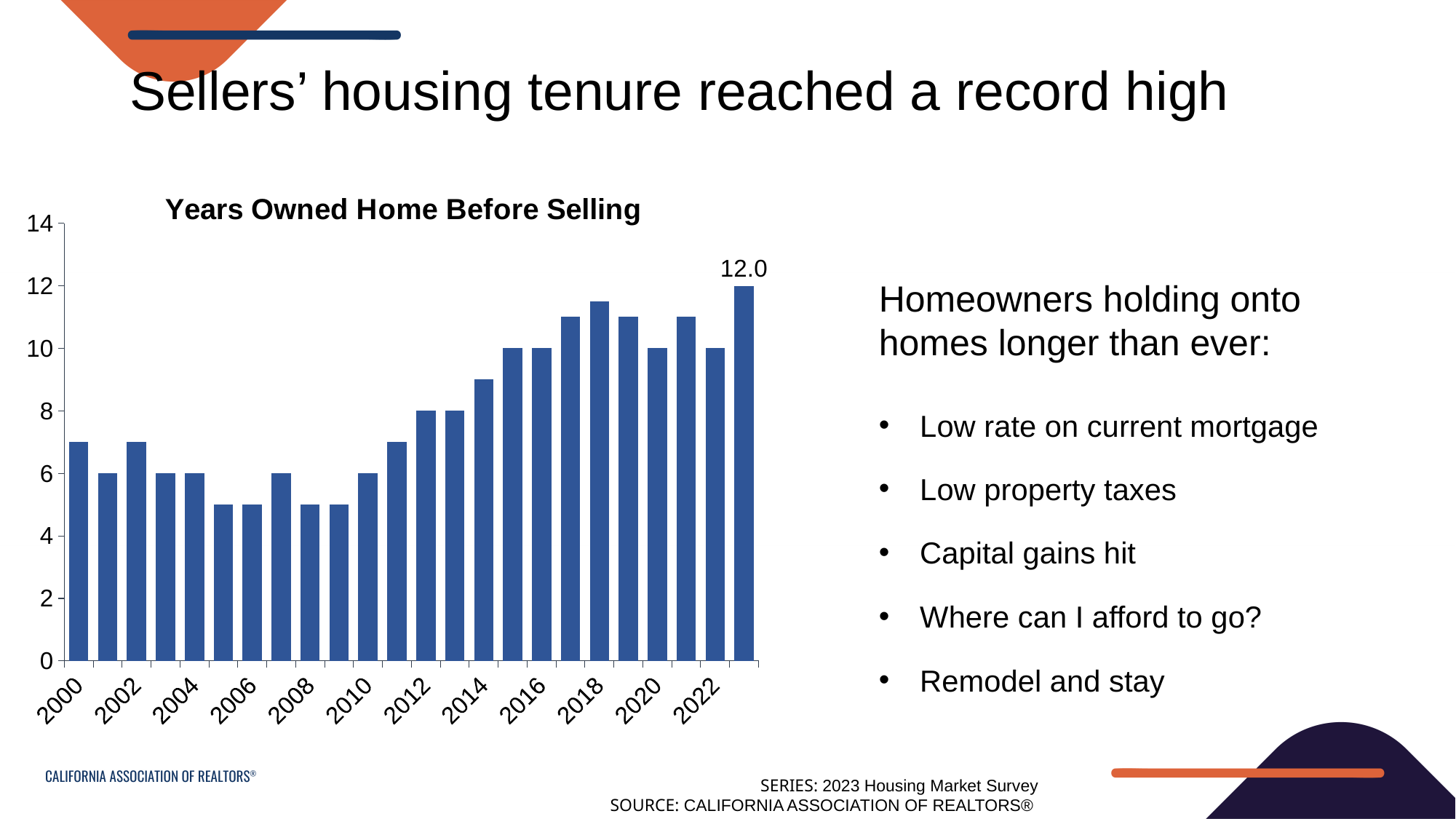
What is the value for 2012? 8 Is the value for 2000 greater or less than 6? greater Is the value for 2006 greater or less than 6? less What is the title of the chart? Years Owned Home Before Selling What is the difference between the value for 2023 and the value for 2022? 2 What kind of chart is shown on the slide? bar chart What is the value for 2004? 6 How many bars are plotted in the chart? 24 Which is larger, the value for 2022 or the value for 2023? 2023 Which year has the highest value? 2023 What is the value for 2016? 10 What is the value for 2023? 12.0